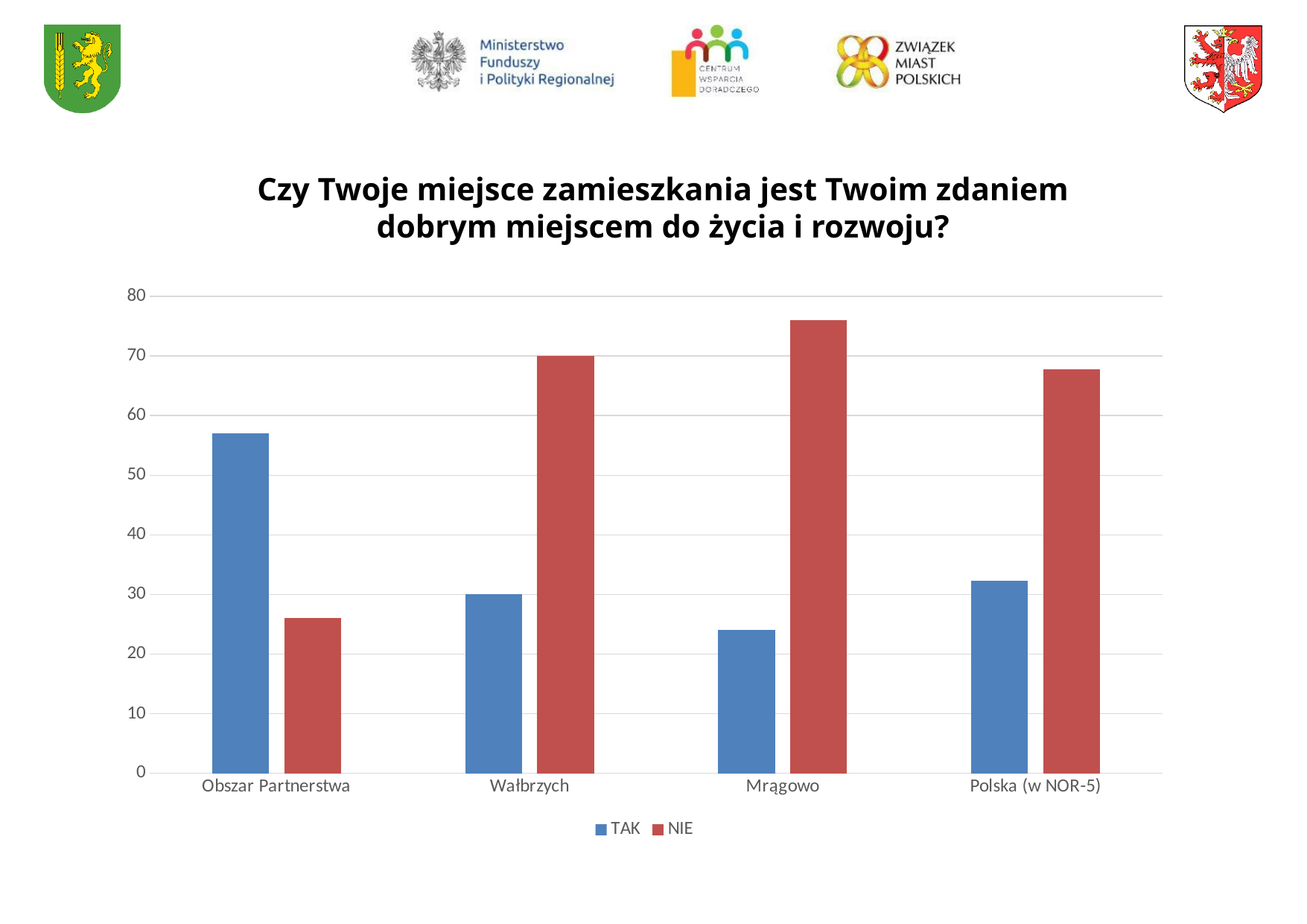
Is the TAK value for Mrągowo greater or less than 30? less Which category has the highest NIE value? Mrągowo Is the NIE value for Mrągowo greater or less than 70? greater Which colour represents the NIE series in the legend? red What kind of chart is shown on the slide? bar chart Which category has the lowest TAK value? Mrągowo Which category has the highest TAK value? Obszar Partnerstwa Is the TAK value for Obszar Partnerstwa greater or less than 50? greater How many categories are shown on the x axis? 4 For Obszar Partnerstwa, which is larger, TAK or NIE? TAK How many series does the legend list? 2